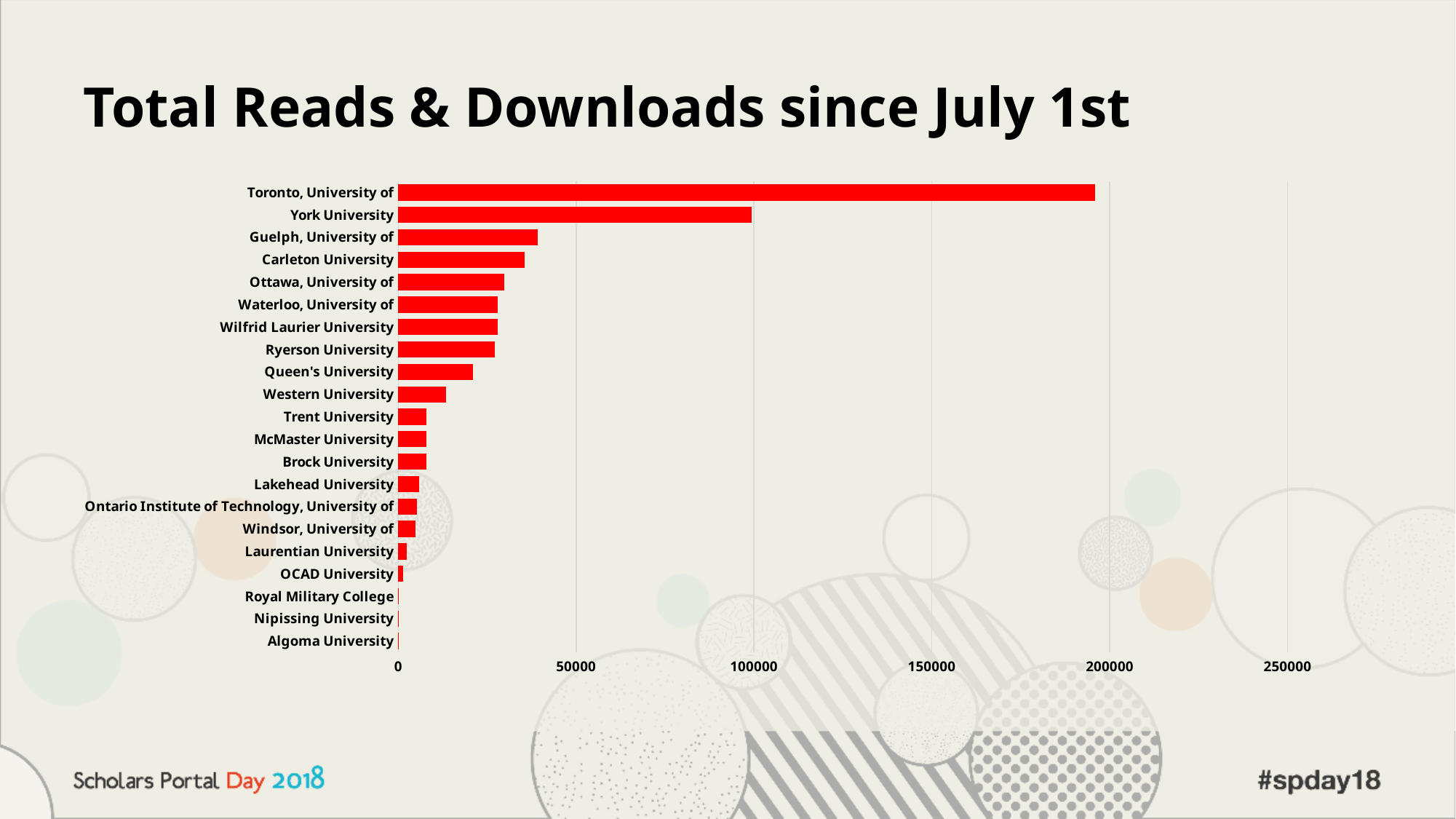
Is the value for Toronto, University of greater or less than 150000? greater Is the value for Toronto, University of greater or less than 200000? less Which university has the highest total reads and downloads? Toronto, University of How many universities are listed on the chart? 21 What kind of chart is shown on the slide? bar chart Going down the list of universities from top to bottom, do the bars get longer or shorter? shorter Which has a larger value, Carleton University or Trent University? Carleton University Which has a larger value, Toronto, University of or York University? Toronto, University of Which has a larger value, Queen's University or Western University? Queen's University Is the value for Western University greater or less than 50000? less What is the title of the chart? Total Reads & Downloads since July 1st